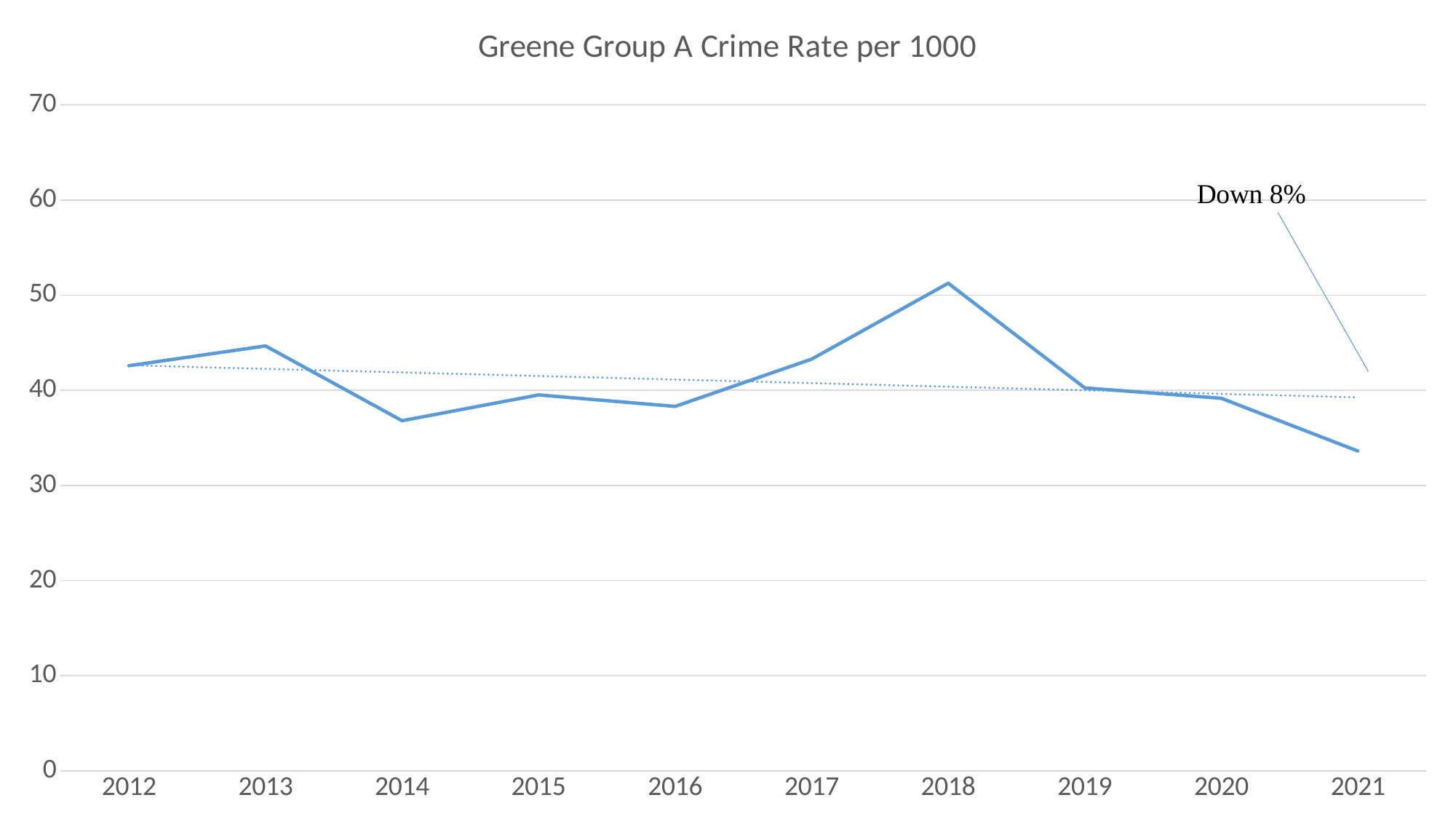
Is the value for 2014 greater or less than 40? less Which year has the highest crime rate? 2018 Which year has the larger value, 2013 or 2014? 2013 Is the value for 2021 greater or less than 40? less What is the title of the chart? Greene Group A Crime Rate per 1000 What does the annotation near the end of the line say? Down 8% What kind of chart is shown on the slide? line chart Is the value for 2013 greater or less than 40? greater Does the crime rate rise or fall from 2018 to 2021? fall Which year has the lowest crime rate? 2021 How many years are plotted along the x axis? 10